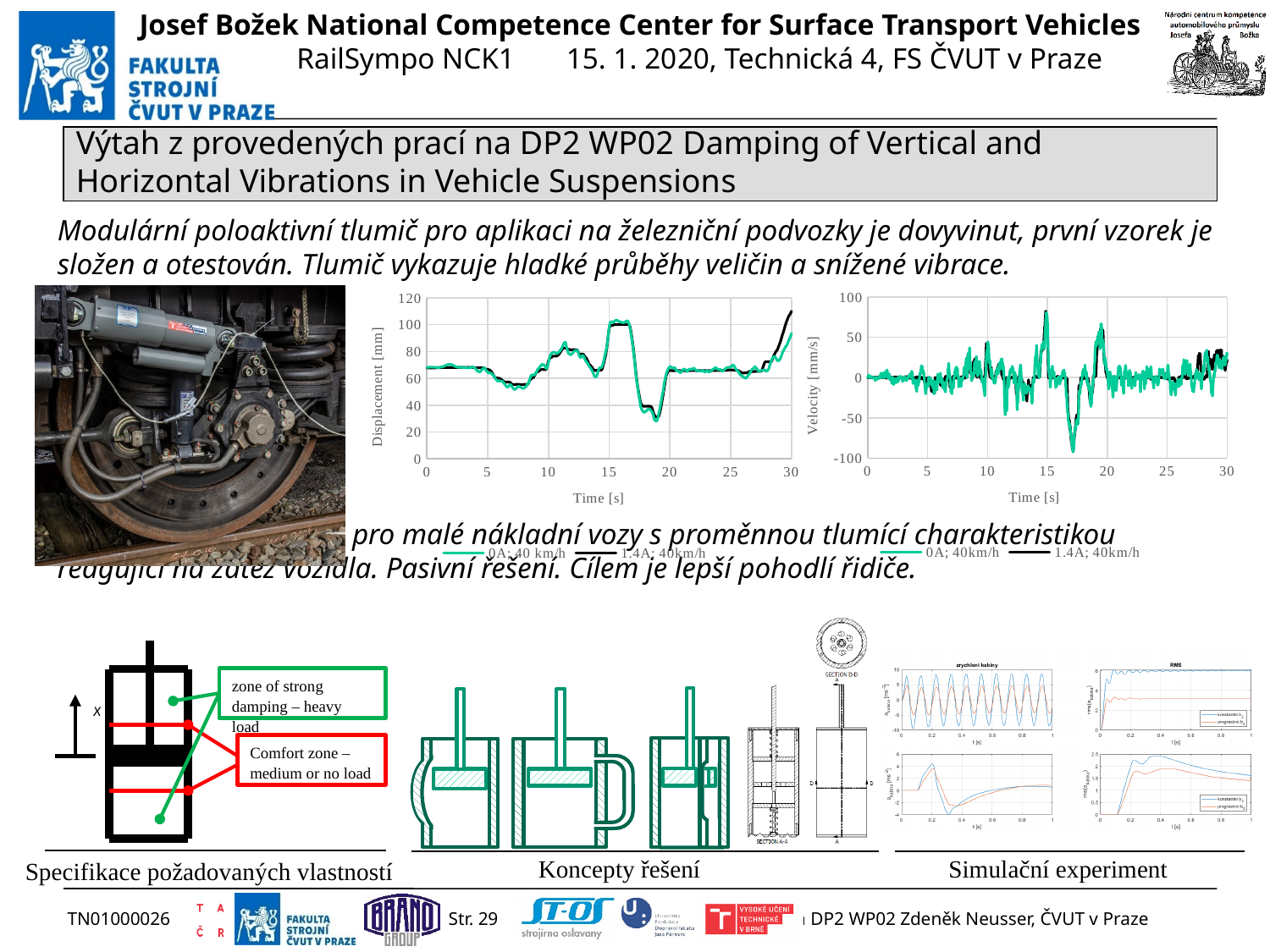
What kind of chart is the Displacement [mm] chart? line chart On the Displacement [mm] chart, is the displacement at time 0 s greater or less than 60? greater On the Velocity [mm/s] chart, is the highest velocity peak near 15 s greater or less than 50? greater How many series does the legend of the Displacement [mm] chart list? 2 What kind of chart is the Velocity [mm/s] chart? line chart On the Velocity [mm/s] chart, is the lowest velocity dip near 17 s greater or less than -50? less How many series does the legend of the Velocity [mm/s] chart list? 2 What are the two legend entries of the Displacement [mm] chart? 0A; 40 km/h and 1.4A; 40km/h What is the label of the x axis on the Velocity [mm/s] chart? Time [s] On the Displacement [mm] chart, is the displacement at 15 s larger or smaller than the displacement at 18 s? larger On the Displacement [mm] chart, does the displacement rise or fall between 25 s and 30 s? rise